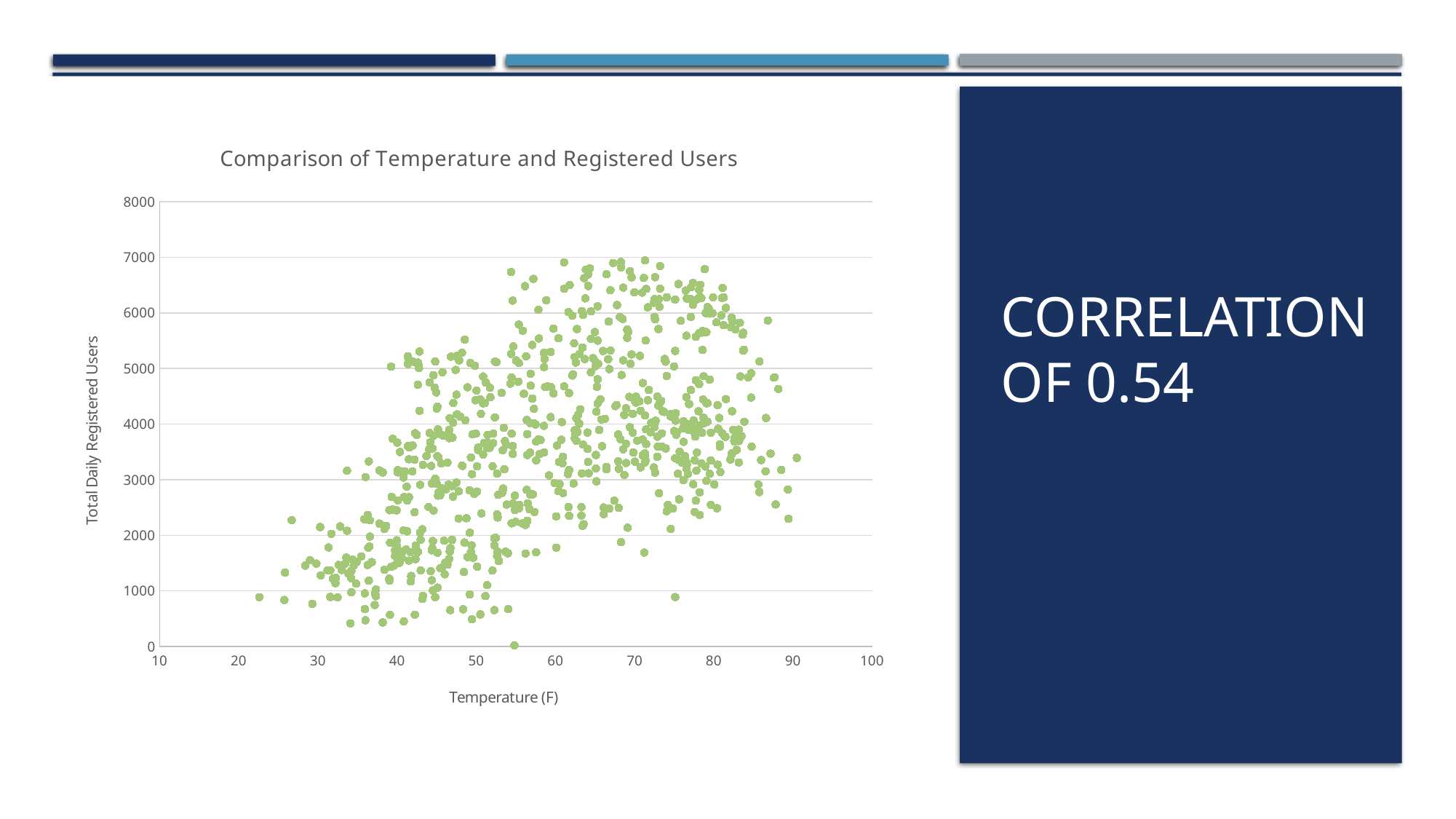
What kind of chart is shown on the slide? Scatter plot What is the lowest tick value shown on the x axis of the chart? 10 Is the highest temperature plotted on the chart greater or less than 100? less What is the highest tick value shown on the y axis of the chart? 8000 Are the points at temperatures around 30 F mostly above or below 3000 registered users? below Do the registered user values generally rise or fall as temperature increases along the x axis? Rise Is the lowest temperature plotted on the chart greater or less than 20? greater What is the label of the x axis of the chart? Temperature (F) What is the title of the chart? Comparison of Temperature and Registered Users